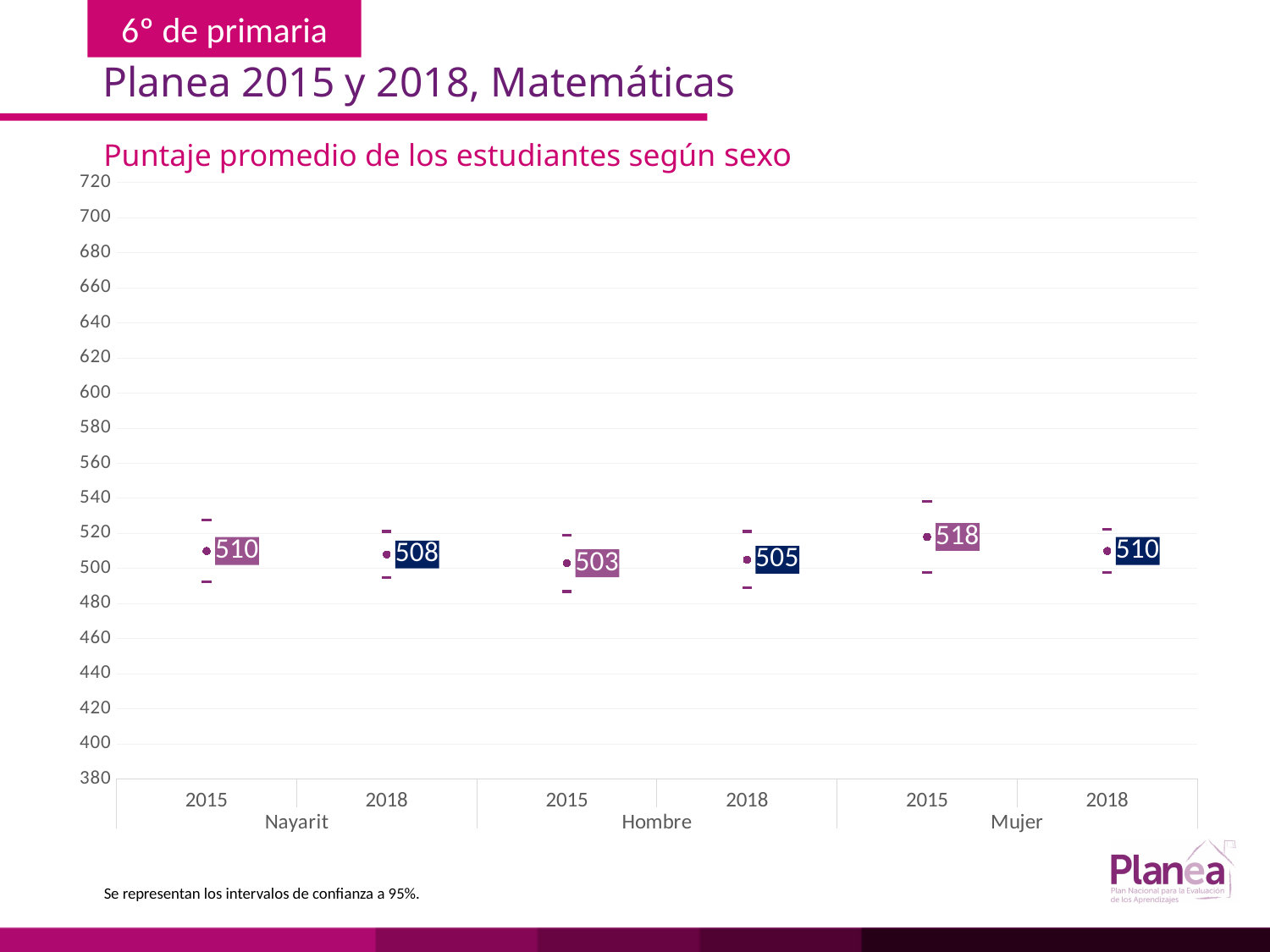
What is the average score for Nayarit in 2015? 510 Which group and year has the highest average score? Mujer 2015 What is the average score for Mujer in 2018? 510 What is the average score for Nayarit in 2018? 508 Which group and year has the lowest average score? Hombre 2015 What is the average score for Hombre in 2018? 505 What is the difference between the Mujer score in 2015 and in 2018? 8 How many data points are plotted on the chart? 6 What is the average score for Mujer in 2015? 518 Which is larger, the Hombre score in 2018 or the Mujer score in 2018? Mujer 2018 What is the average score for Hombre in 2015? 503 What is the title of the chart? Puntaje promedio de los estudiantes según sexo